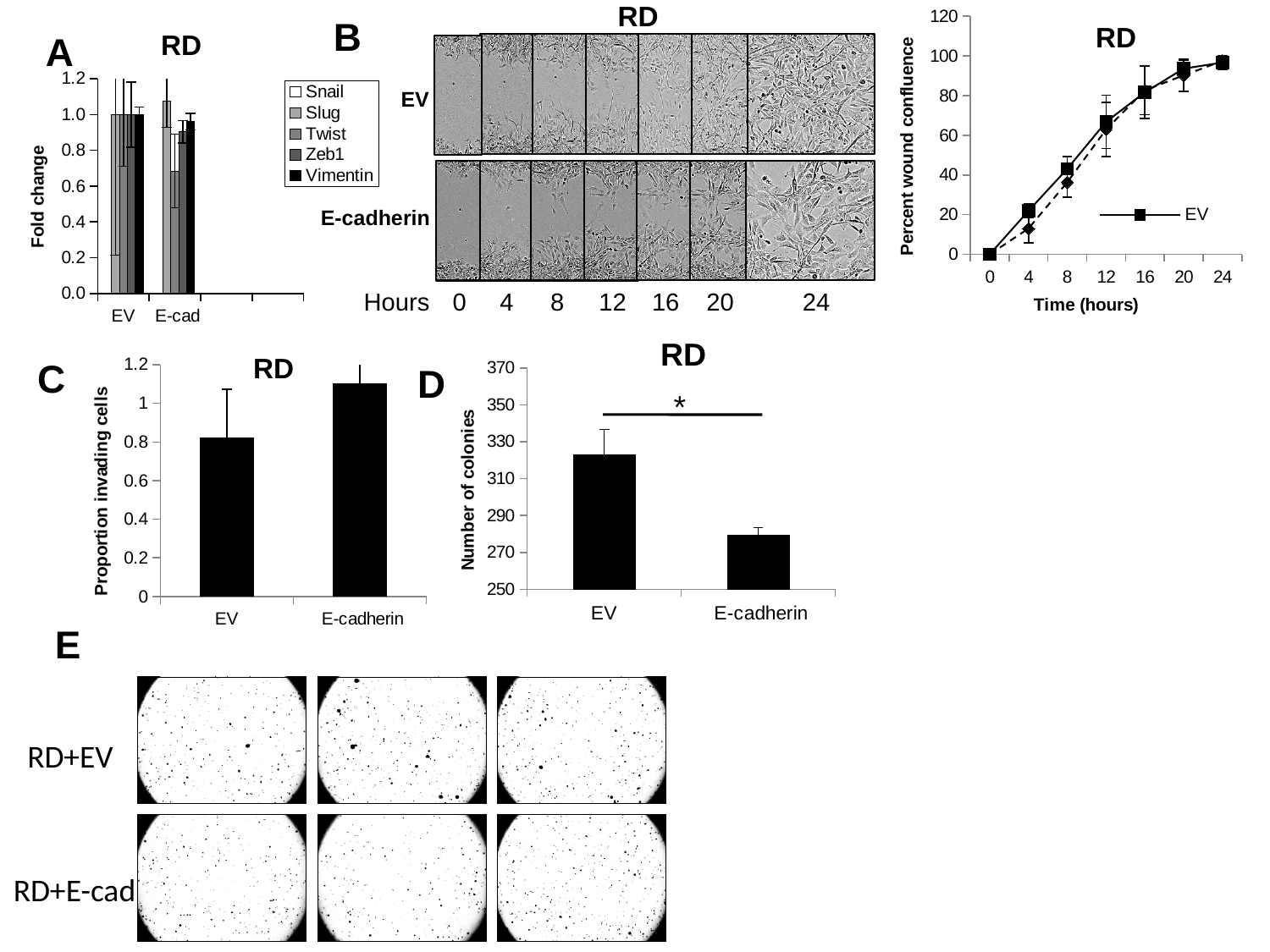
In the chart in panel D (Number of colonies), which category has the highest bar? EV In the chart in panel A (Fold change), what are the two categories on the x axis? EV and E-cad In the line chart in panel B (Percent wound confluence), is the EV value at 4 hours greater or less than 40? less In the chart in panel A (Fold change), how many series does the legend list? 5 In the chart in panel C (Proportion invading cells), is the value for EV greater or less than 1? less In the chart in panel D (Number of colonies), is the value for EV greater or less than 310? greater In the line chart in panel B (Percent wound confluence), do the values rise or fall as time increases? rise In the chart in panel A (Fold change), what kind of chart is shown? bar chart In the chart in panel C (Proportion invading cells), which category has the higher bar, EV or E-cadherin? E-cadherin In the line chart in panel B (Percent wound confluence), how many time points are plotted along the x axis? 7